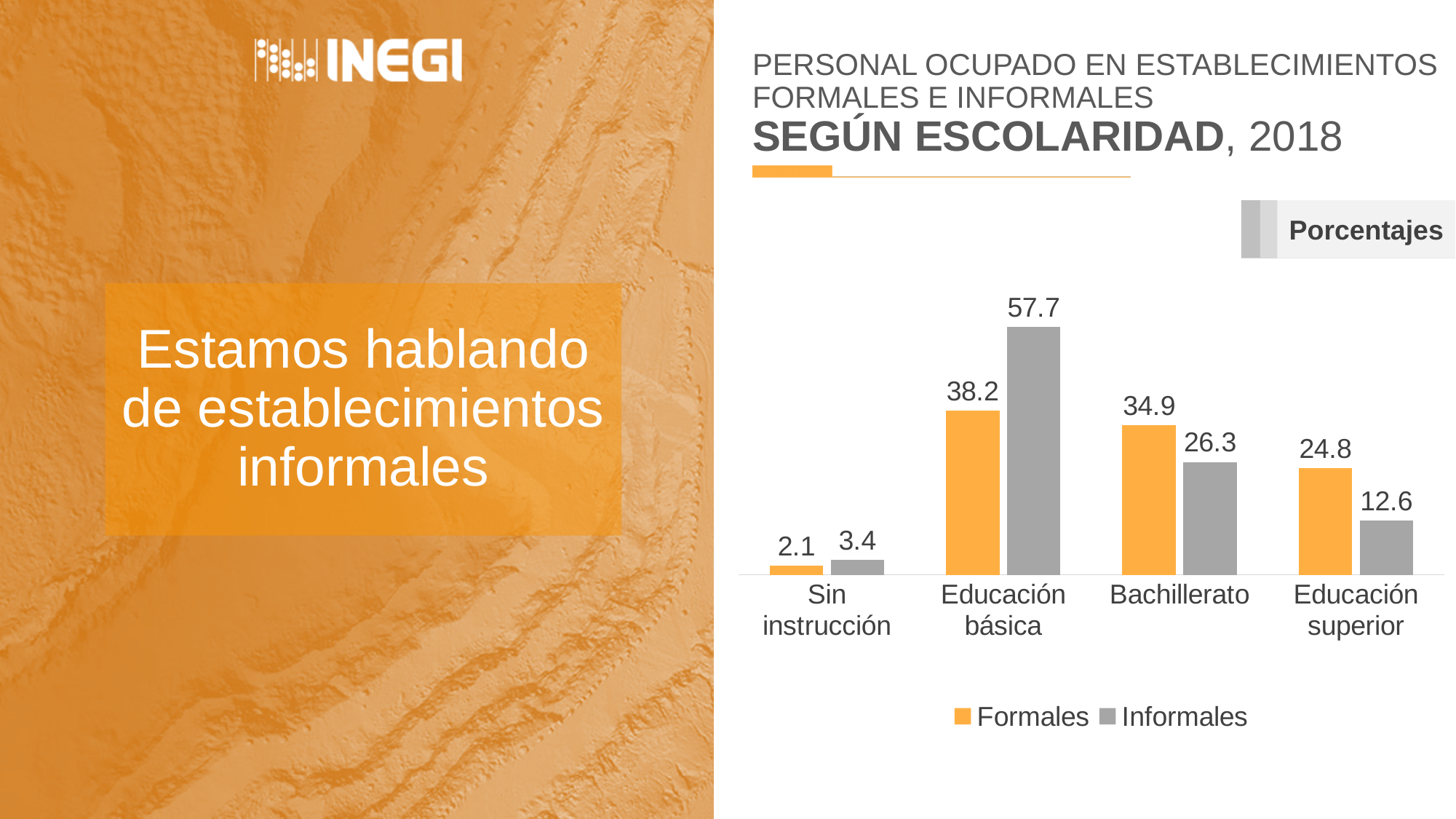
How many series does the legend list? 2 What is the Informales value for Bachillerato? 26.3 What is the Formales value for Educación superior? 24.8 What kind of chart is shown on the slide? Bar chart What is the Formales value for Educación básica? 38.2 What is the difference between the Formales and Informales values for Educación superior? 12.2 How many education categories are shown on the x axis? 4 What is the difference between the Informales and Formales values for Educación básica? 19.5 What is the Informales value for Sin instrucción? 3.4 Which is larger for Bachillerato, the Formales value or the Informales value? Formales Which category has the highest Informales value? Educación básica Which category has the lowest Formales value? Sin instrucción